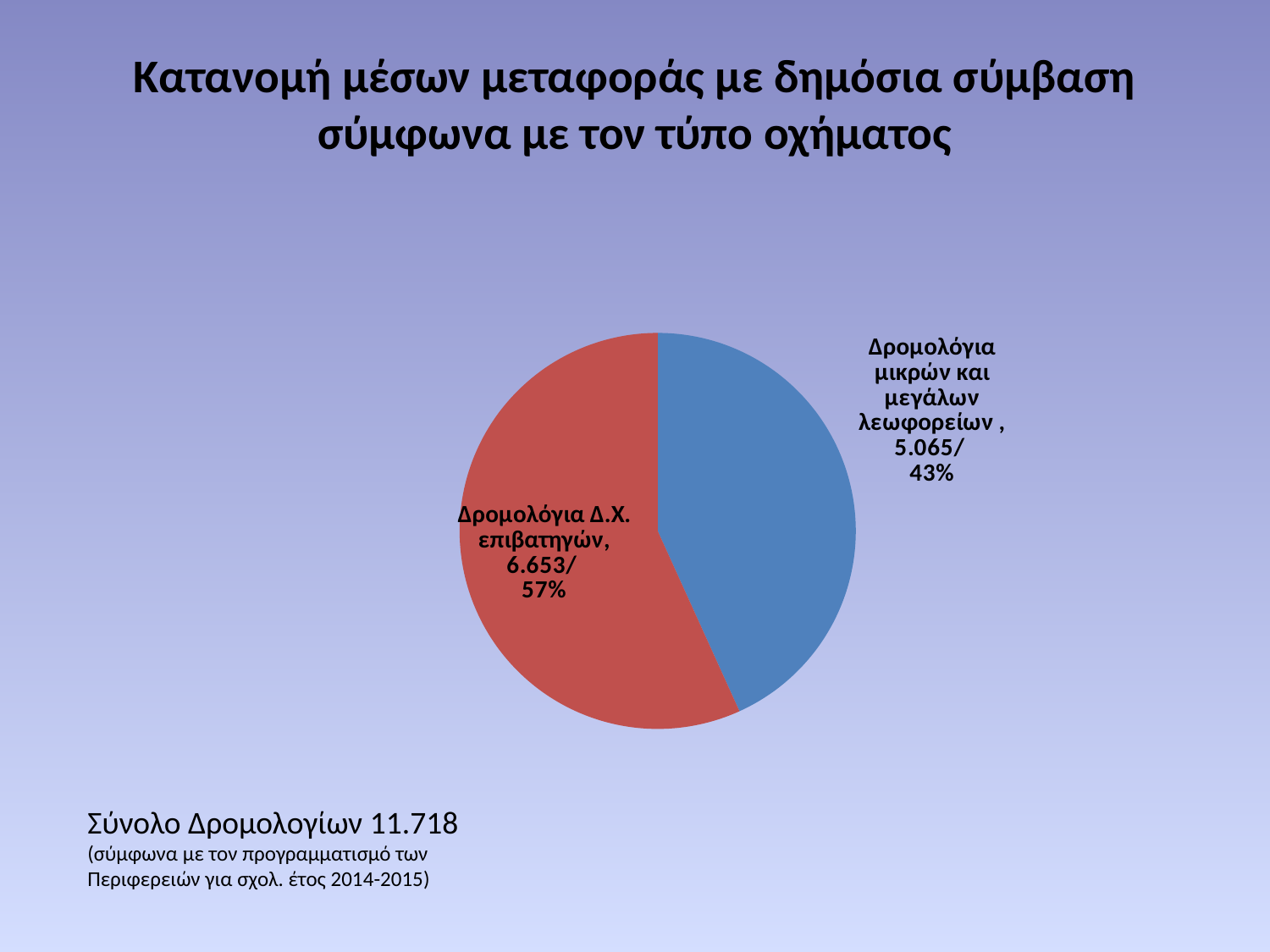
What share of the pie does Δρομολόγια μικρών και μεγάλων λεωφορείων represent? 43% Which is larger, Δρομολόγια Δ.Χ. επιβατηγών or Δρομολόγια μικρών και μεγάλων λεωφορείων? Δρομολόγια Δ.Χ. επιβατηγών What kind of chart is shown on the slide? pie chart What colour is the slice for Δρομολόγια μικρών και μεγάλων λεωφορείων? blue What is the difference between the values for Δρομολόγια Δ.Χ. επιβατηγών and Δρομολόγια μικρών και μεγάλων λεωφορείων? 1.588 What share of the pie does Δρομολόγια Δ.Χ. επιβατηγών represent? 57% Which slice is the largest? Δρομολόγια Δ.Χ. επιβατηγών Which slice is the smallest? Δρομολόγια μικρών και μεγάλων λεωφορείων What is the total of the two slices of the pie chart? 11.718 What is the value for Δρομολόγια μικρών και μεγάλων λεωφορείων? 5.065 What is the value for Δρομολόγια Δ.Χ. επιβατηγών? 6.653 How many slices does the pie chart have? 2